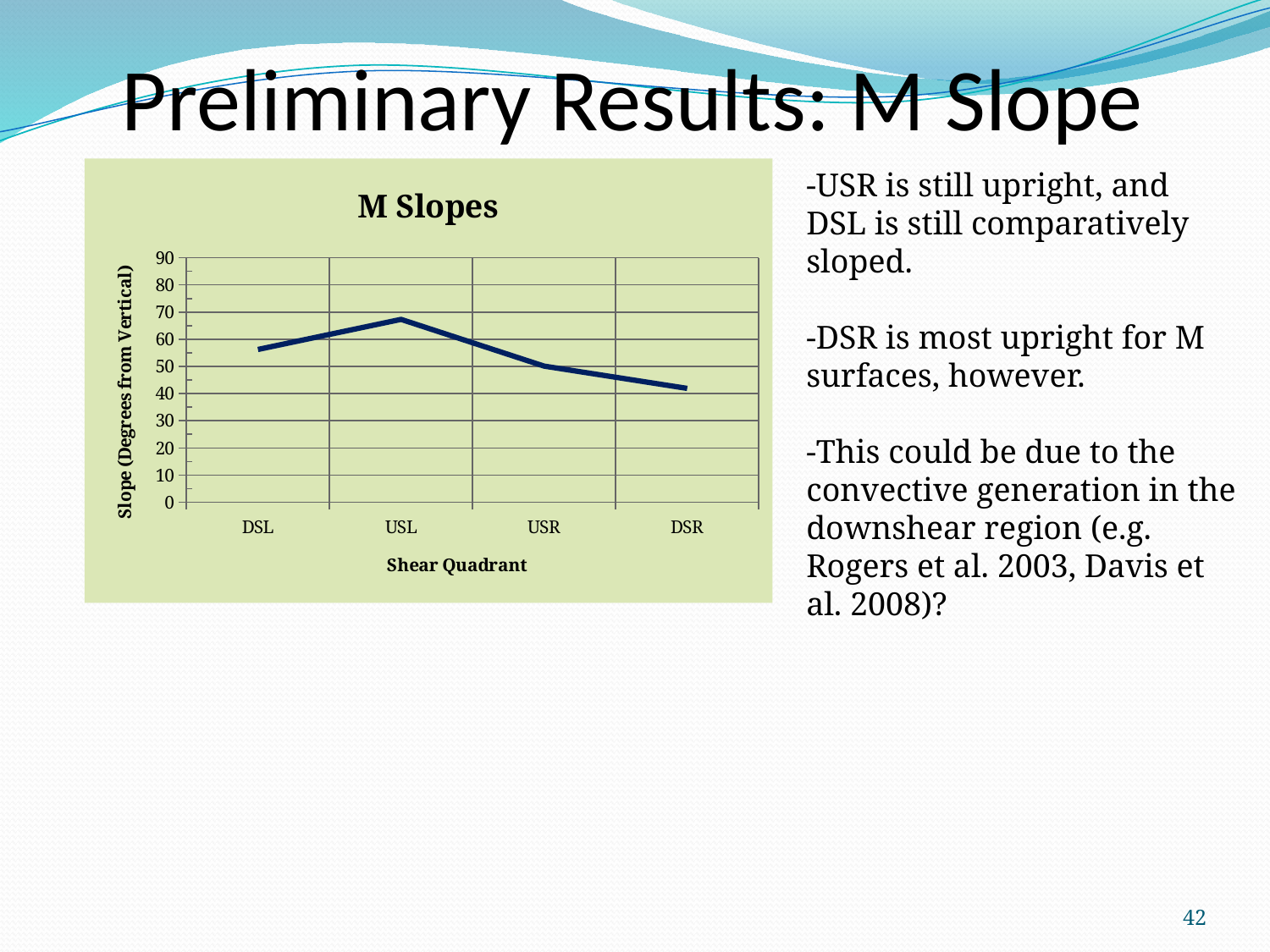
What kind of chart is shown on the slide? line chart Is the value for USL greater or less than 60? greater Is the value for DSL greater or less than 50? greater How many shear quadrants are plotted on the x axis? 4 Which shear quadrant has the highest slope value? USL Which shear quadrant has the lowest slope value? DSR Is the value for USR greater or less than 60? less Do the values rise or fall from USL to DSR along the x axis? fall Which has a larger slope value, DSL or DSR? DSL What is the label of the y axis? Slope (Degrees from Vertical) What is the title of the chart? M Slopes